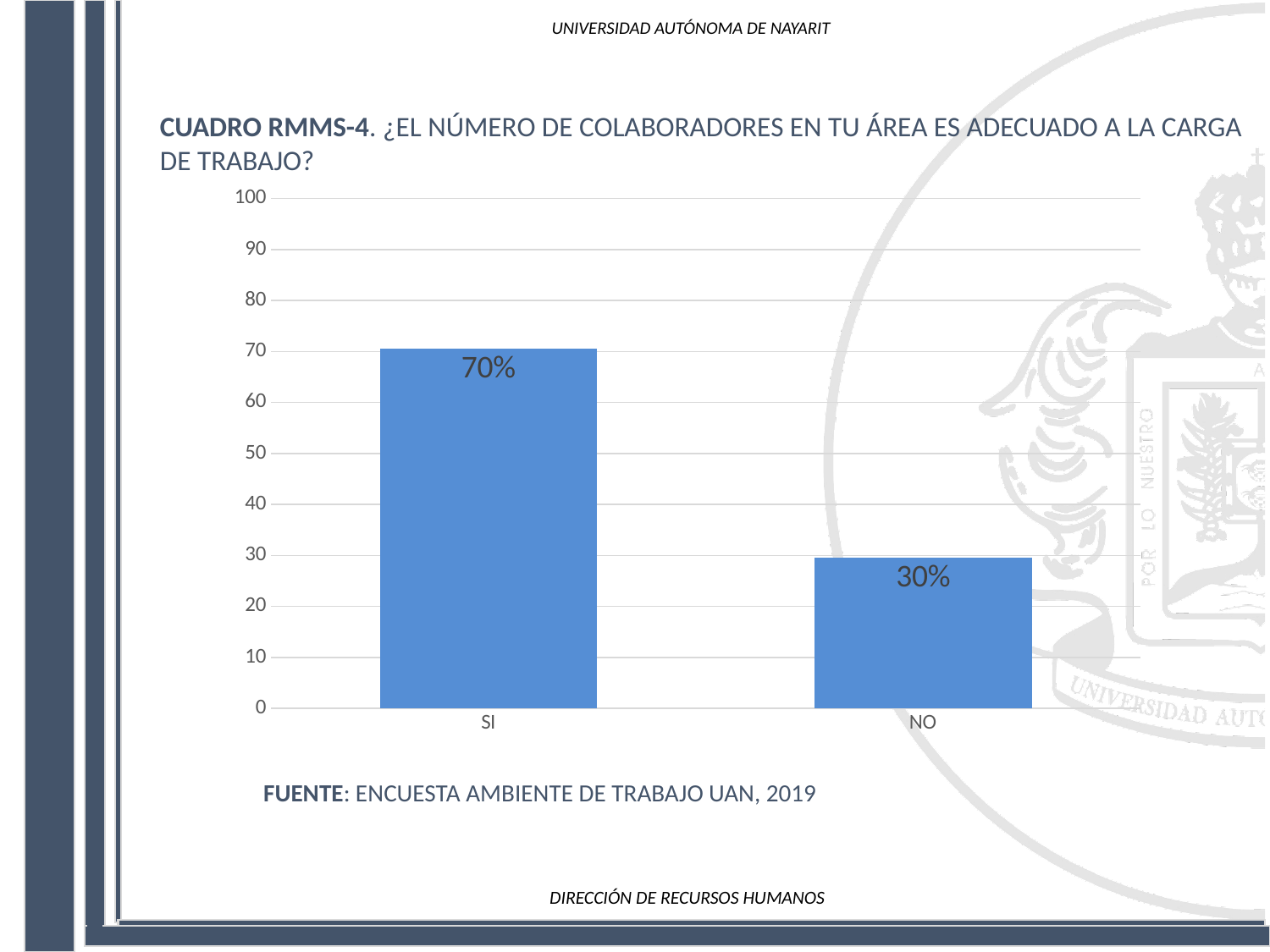
What kind of chart is shown on the slide? bar chart What is the difference between the values for SI and NO? 40% Which category has the highest value? SI Is the value for SI greater or less than 60? greater What is the value for NO? 30% Is the value for NO greater or less than 40? less What is the source cited below the chart? ENCUESTA AMBIENTE DE TRABAJO UAN, 2019 What is the value for SI? 70% How many categories are shown on the x axis? 2 What is the maximum value shown on the y axis? 100 Which is larger, the value for SI or the value for NO? SI Which category has the lowest value? NO